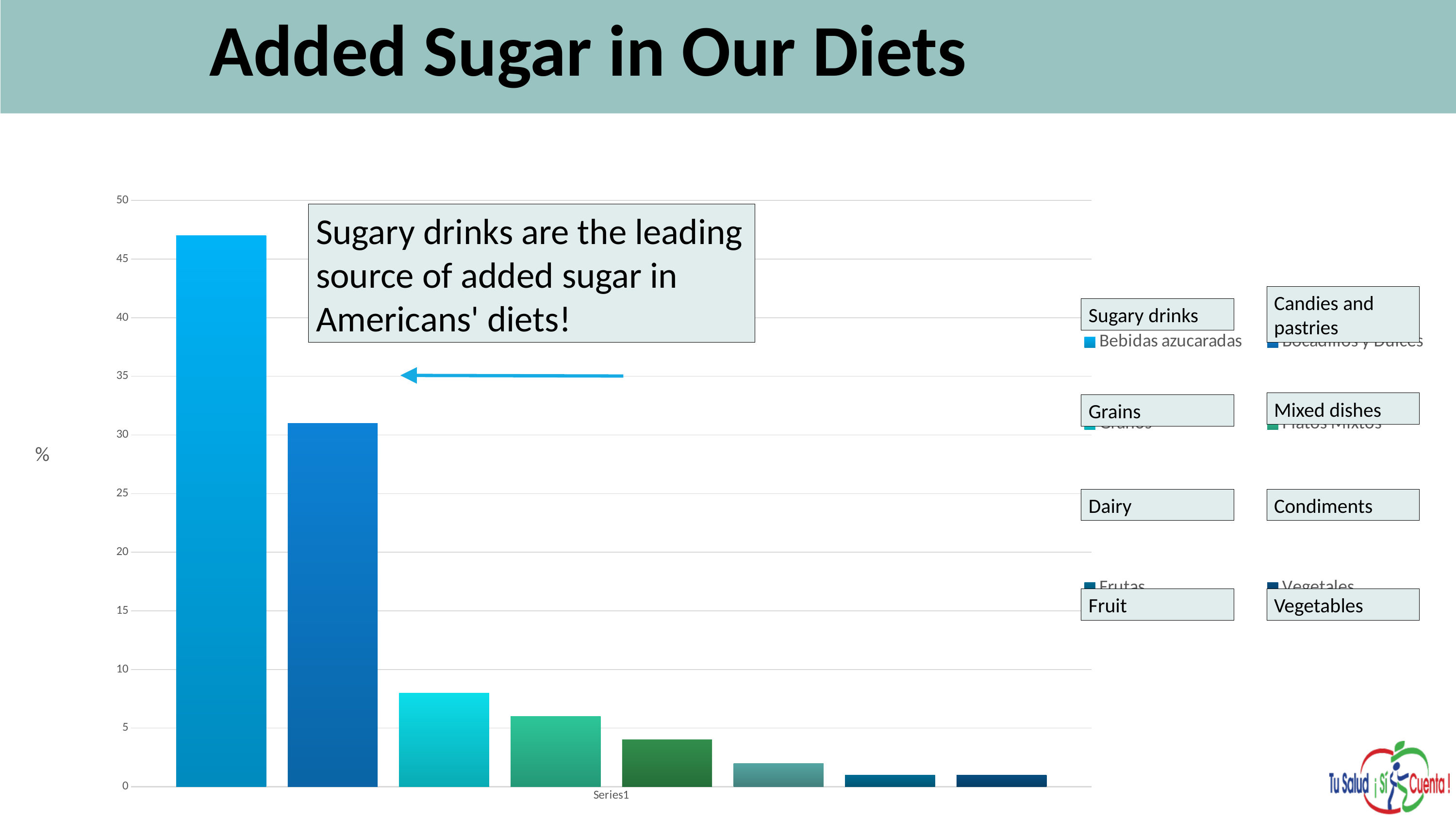
What kind of chart is shown on the slide? bar chart Is the value for Candies and pastries greater or less than 35? less How many bars are plotted in the chart? 8 According to the text box on the chart, what is the leading source of added sugar in Americans' diets? Sugary drinks Which is larger, the value for Sugary drinks or the value for Candies and pastries? Sugary drinks Which category has the highest value in the chart? Sugary drinks Is the value for Condiments greater or less than 5? less Is the value for Sugary drinks greater or less than 45? greater Do the bar values rise or fall from left to right across the chart? fall Which is larger, the value for Grains or the value for Dairy? Grains What is the label on the vertical axis of the chart? %